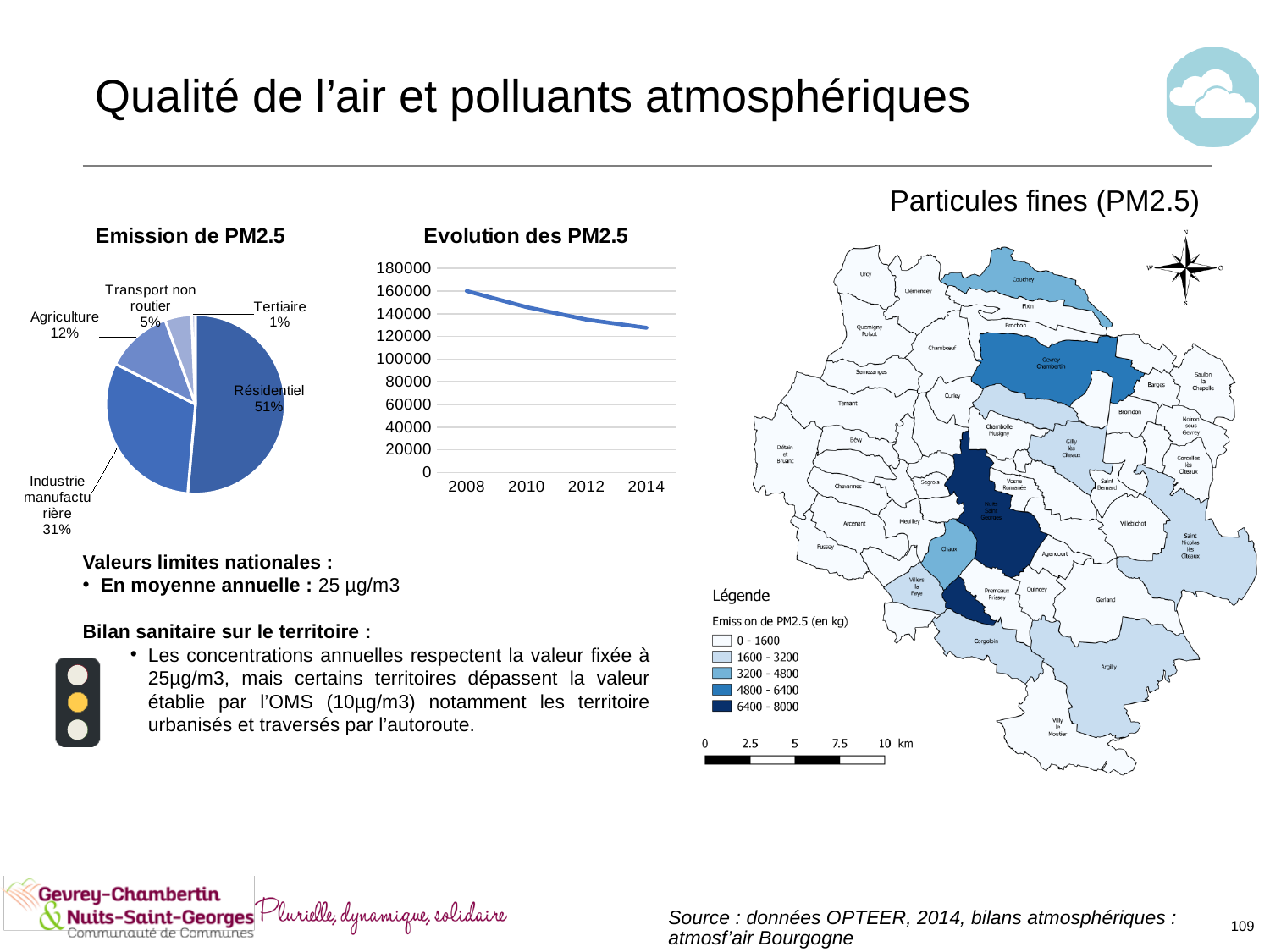
In the pie chart 'Emission de PM2.5', what share is attributed to Résidentiel? 51% In the chart 'Evolution des PM2.5', do the values rise or fall from 2008 to 2014? Fall In the pie chart 'Emission de PM2.5', which sector has the largest share? Résidentiel In the chart 'Evolution des PM2.5', is the value for 2014 greater or less than 140000? less How many sectors are shown in the pie chart 'Emission de PM2.5'? 5 In the pie chart 'Emission de PM2.5', what share is attributed to Industrie manufacturière? 31% In the pie chart 'Emission de PM2.5', which sector has the smallest share? Tertiaire In the pie chart 'Emission de PM2.5', what share is attributed to Transport non routier? 5% In the pie chart 'Emission de PM2.5', what share is attributed to Agriculture? 12% In the chart 'Evolution des PM2.5', is the value for 2008 greater or less than 140000? greater In the pie chart 'Emission de PM2.5', how many percentage points larger is the Résidentiel share than the Industrie manufacturière share? 20 What kind of chart is 'Emission de PM2.5'? Pie chart